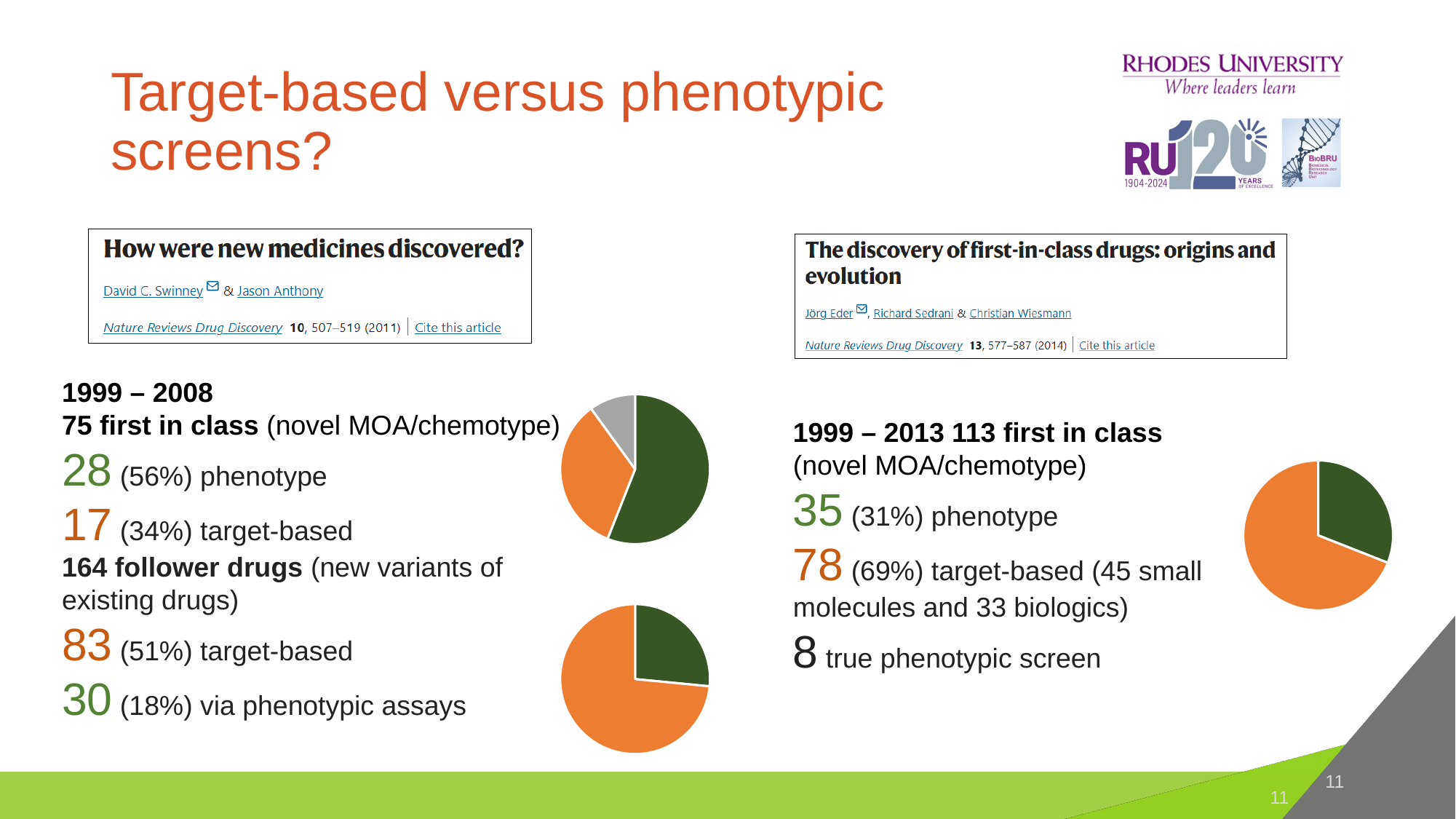
How many pie charts are shown on the slide? 3 In the bottom-left pie chart (164 follower drugs), how many follower drugs were target-based? 83 In the top-left pie chart (1999–2008 first in class), what share of first-in-class drugs were target-based? 34% In the right-hand pie chart (1999–2013 first in class), what share of first-in-class drugs were target-based? 69% In the top-left pie chart (1999–2008 first in class), which is larger: the phenotype slice or the target-based slice? phenotype In the right-hand pie chart (1999–2013 first in class), what is the difference between the number of target-based and phenotype first-in-class drugs? 43 What kind of chart is used to show the 1999–2008 first-in-class drug breakdown on the left of the slide? pie chart In the right-hand pie chart (1999–2013 first in class), which is larger: the phenotype slice or the target-based slice? target-based In the bottom-left pie chart (164 follower drugs), how many slices are there? 2 In the top-left pie chart (1999–2008 first in class), how many slices are there? 3 In the top-left pie chart (1999–2008 first in class), what share of first-in-class drugs came from phenotype screens? 56% In the bottom-left pie chart (164 follower drugs), which slice is larger: target-based or via phenotypic assays? target-based